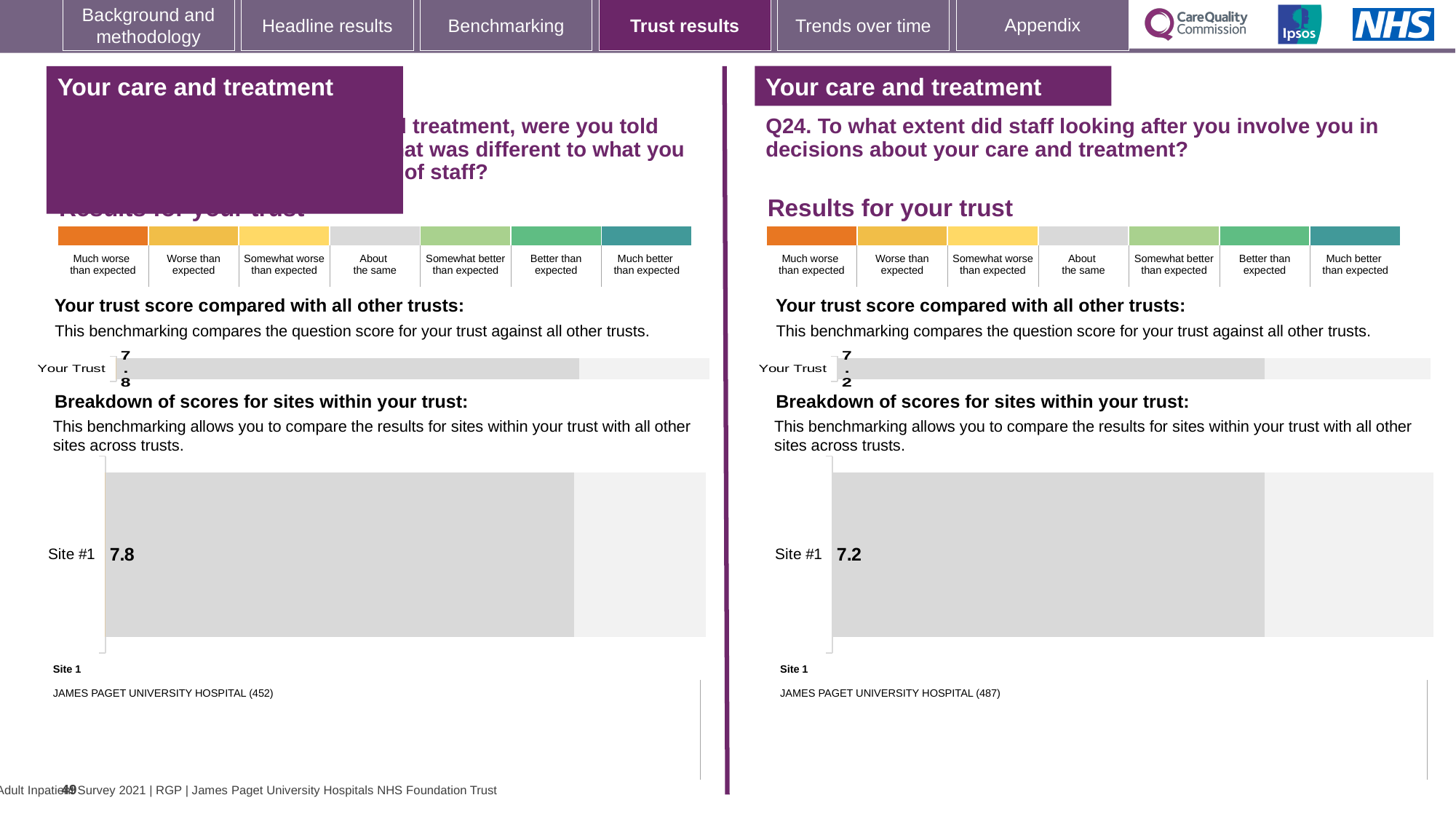
On the left panel, what is the score shown for Your Trust in the 'Your trust score compared with all other trusts' chart? 7.8 Which is larger: the Your Trust score on the left panel or the Your Trust score on the right panel (Q24)? Left panel On the right panel (Q24), what is the score shown for Your Trust in the 'Your trust score compared with all other trusts' chart? 7.2 How many sites are shown in the 'Breakdown of scores for sites within your trust' chart on the right panel (Q24)? 1 Is the Your Trust score on the right panel (Q24) greater or less than the Site #1 score on the left panel? less On the left panel, what is the score shown for Site #1 in the 'Breakdown of scores for sites within your trust' chart? 7.8 How many sites are shown in the 'Breakdown of scores for sites within your trust' chart on the left panel? 1 What kind of chart is used to show the Site #1 score on the right panel (Q24)? Bar chart On the right panel (Q24), what is the score shown for Site #1 in the 'Breakdown of scores for sites within your trust' chart? 7.2 What is the difference between the Site #1 score on the left panel and the Site #1 score on the right panel (Q24)? 0.6 On the right panel (Q24), which site name is listed under Site 1 below the chart? JAMES PAGET UNIVERSITY HOSPITAL (487) On the left panel, which site name is listed under Site 1 below the chart? JAMES PAGET UNIVERSITY HOSPITAL (452)